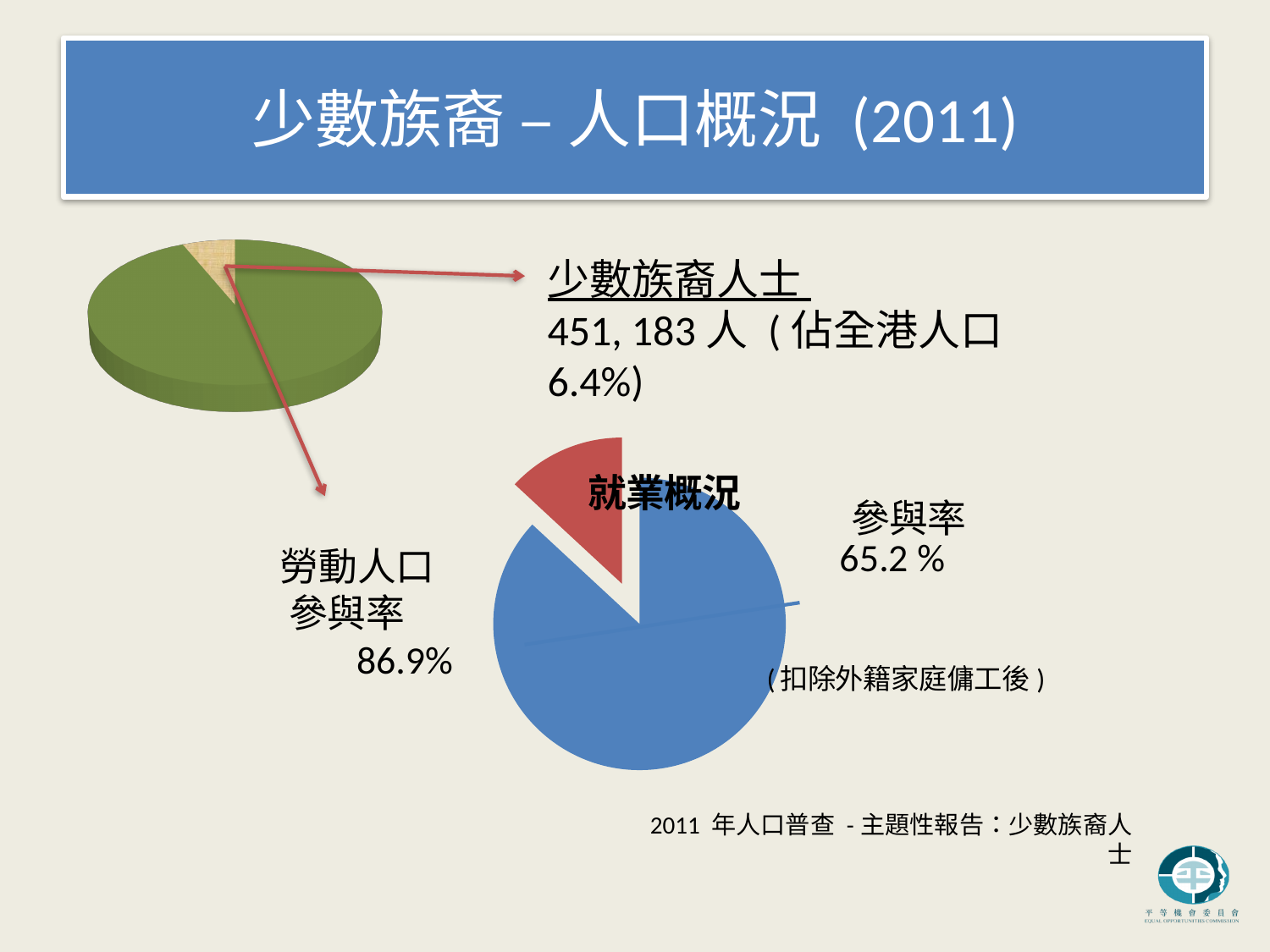
According to the text linked to the top-left pie chart, how many ethnic minority persons (少數族裔人士) are there? 451, 183 人 According to the top-left pie chart, what share of Hong Kong's total population do ethnic minorities (少數族裔人士) make up? 6.4% In the pie chart titled 就業概況, which slice is larger, the blue one or the red one? blue How many slices does the pie chart titled 就業概況 have? 2 What participation rate (參與率) is shown for the pie chart titled 就業概況 after excluding foreign domestic helpers (扣除外籍家庭傭工後)? 65.2 % What labour force participation rate (勞動人口參與率) is shown next to the pie chart titled 就業概況? 86.9% How many slices does the top-left pie chart have? 2 In the top-left pie chart, which slice is larger, the green one or the tan one? green What kind of chart is the chart at the top left of the slide? pie chart In the pie chart titled 就業概況, what colour is the exploded (pulled-out) slice? red What is the title of the lower pie chart on the slide? 就業概況 What kind of chart is the chart titled 就業概況? pie chart